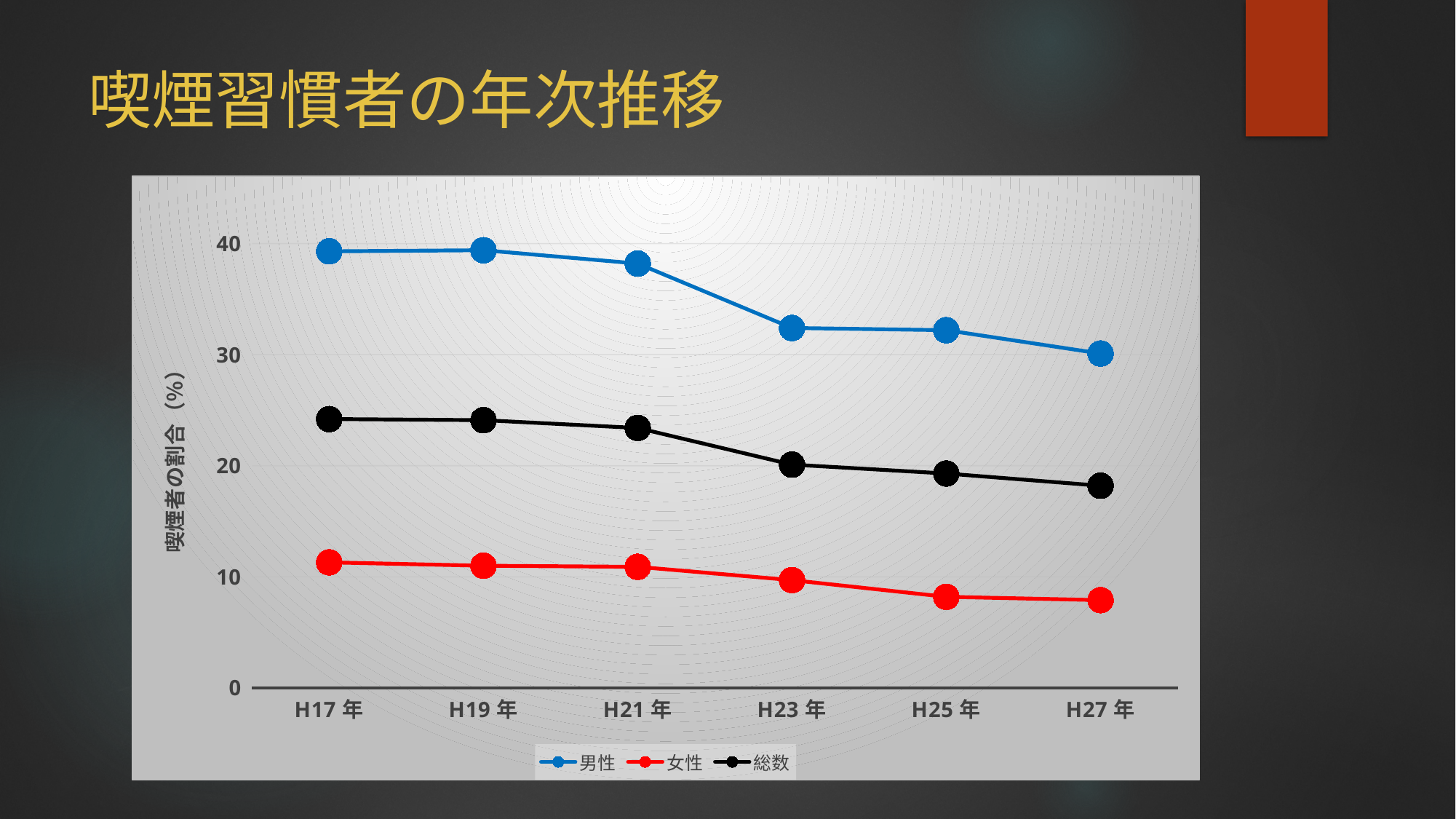
Which series has the lowest values throughout the chart? 女性 Which series has the highest values throughout the chart? 男性 Is the value for 女性 in H27年 greater or less than 10? less What kind of chart is shown on the slide? line chart How many years are plotted along the x axis? 6 How many series does the legend list? 3 Which is larger, the value for 男性 in H21年 or the value for 男性 in H23年? H21年 Do the values for 総数 rise or fall from H17年 to H27年? fall Is the value for 総数 in H27年 greater or less than 20? less Do the values for 男性 rise or fall from H17年 to H27年? fall What is the title of the chart on the slide? 喫煙習慣者の年次推移 Is the value for 男性 in H17年 greater or less than 30? greater